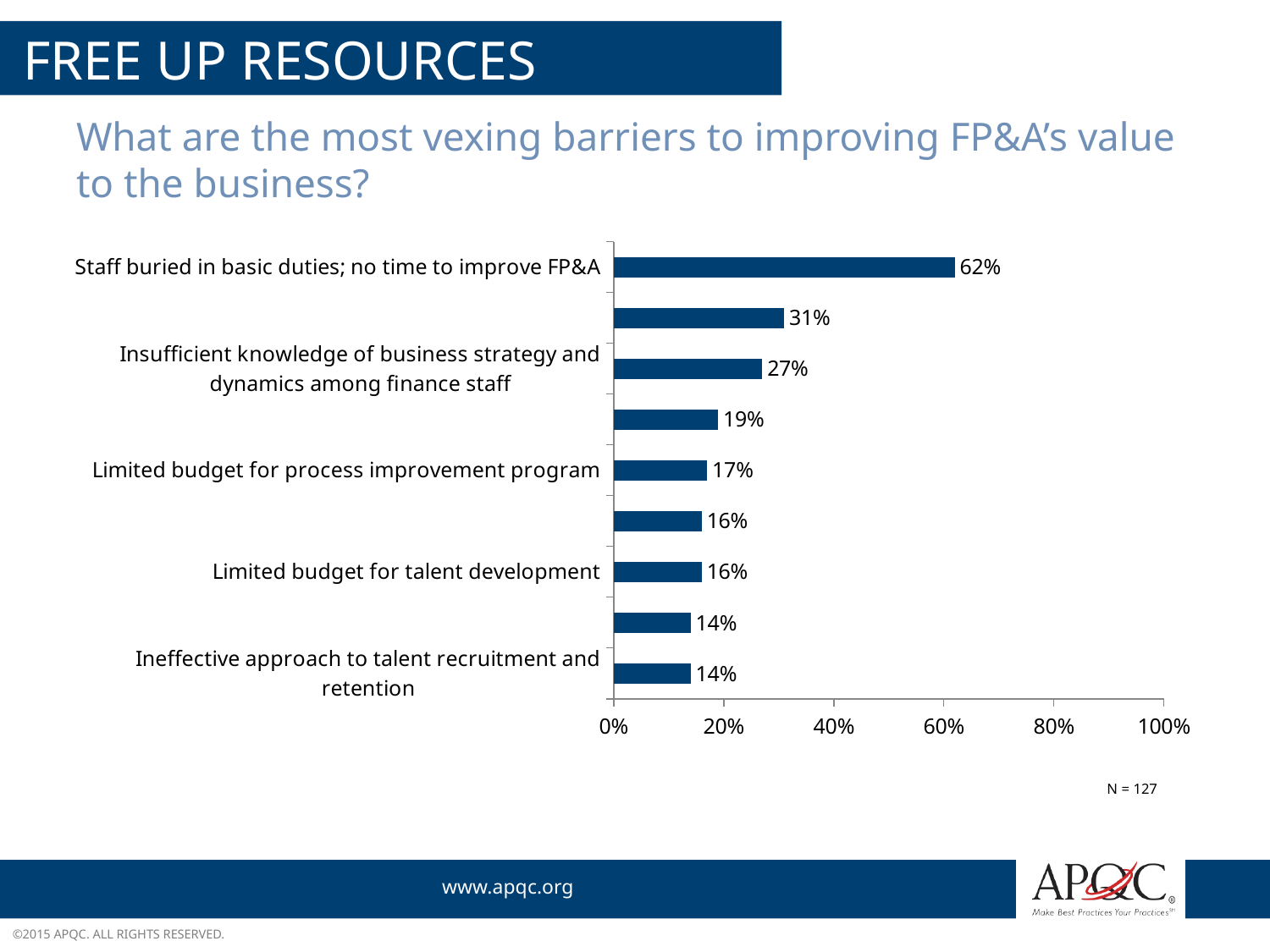
How many bars are plotted in the chart? 9 What is the sample size (N) noted below the chart? N = 127 Is the value for "Staff buried in basic duties; no time to improve FP&A" greater or less than 60%? greater What percentage of respondents cited "Staff buried in basic duties; no time to improve FP&A" as a barrier? 62% What is the difference between the values for "Staff buried in basic duties; no time to improve FP&A" and "Insufficient knowledge of business strategy and dynamics among finance staff"? 35 percentage points Which is larger: the value for "Limited budget for process improvement program" or the value for "Limited budget for talent development"? Limited budget for process improvement program What is the value for "Insufficient knowledge of business strategy and dynamics among finance staff"? 27% What is the value for "Limited budget for process improvement program"? 17% Which barrier has the highest percentage? Staff buried in basic duties; no time to improve FP&A What is the value for "Limited budget for talent development"? 16% What kind of chart is shown on the slide? bar chart What is the value for "Ineffective approach to talent recruitment and retention"? 14%